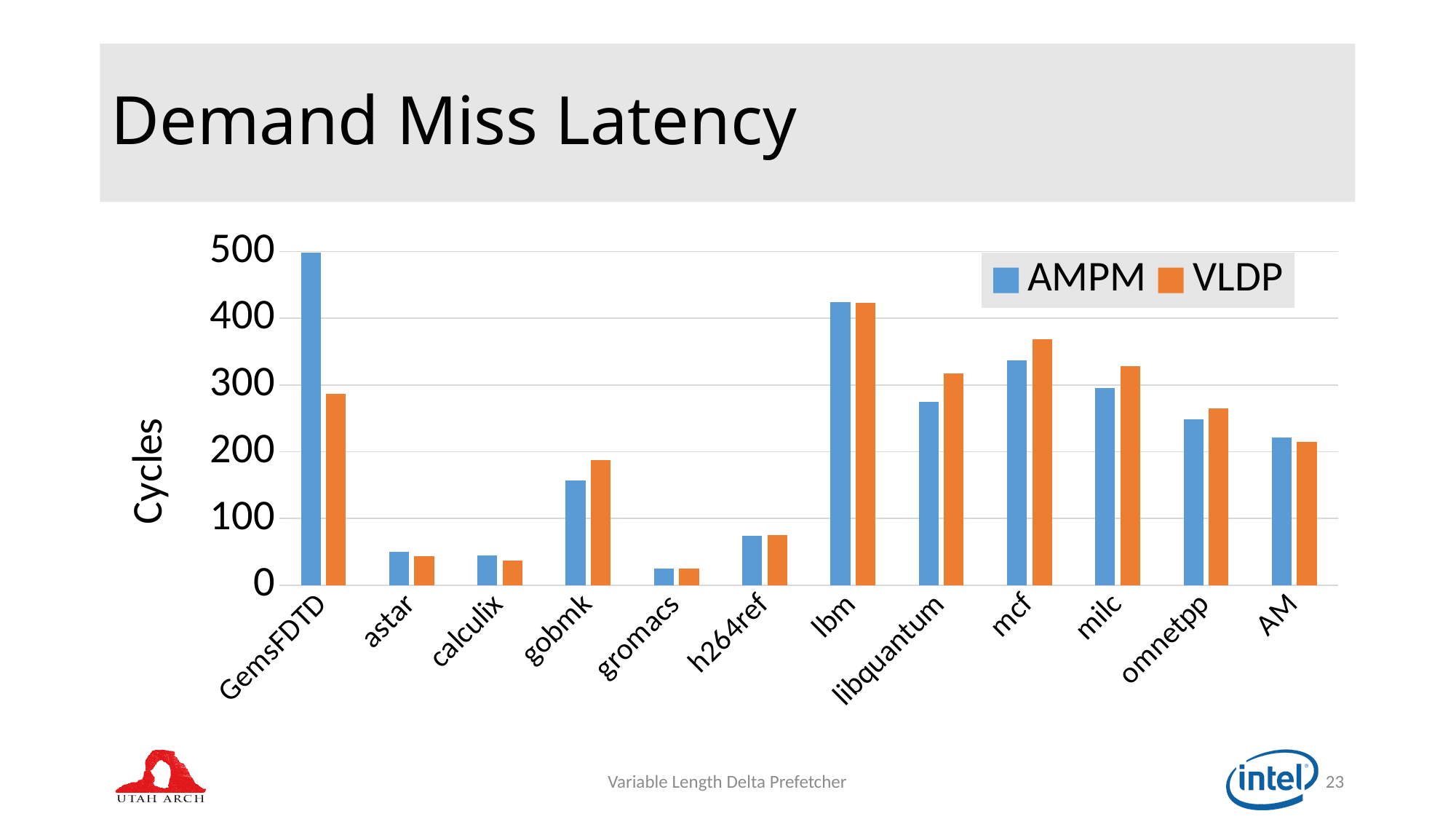
Is the VLDP value for GemsFDTD greater or less than 300? less For gobmk, which series has the larger value, AMPM or VLDP? VLDP For GemsFDTD, which series has the larger value, AMPM or VLDP? AMPM Is the VLDP value for mcf greater or less than 300? greater Which category has the lowest AMPM value? gromacs How many series does the legend list? 2 Which category has the highest AMPM value? GemsFDTD How many benchmark categories are shown on the x axis? 12 Is the AMPM value for GemsFDTD greater or less than 400? greater Which category has the highest VLDP value? lbm What is the label on the y axis? Cycles What kind of chart is shown on the slide? bar chart